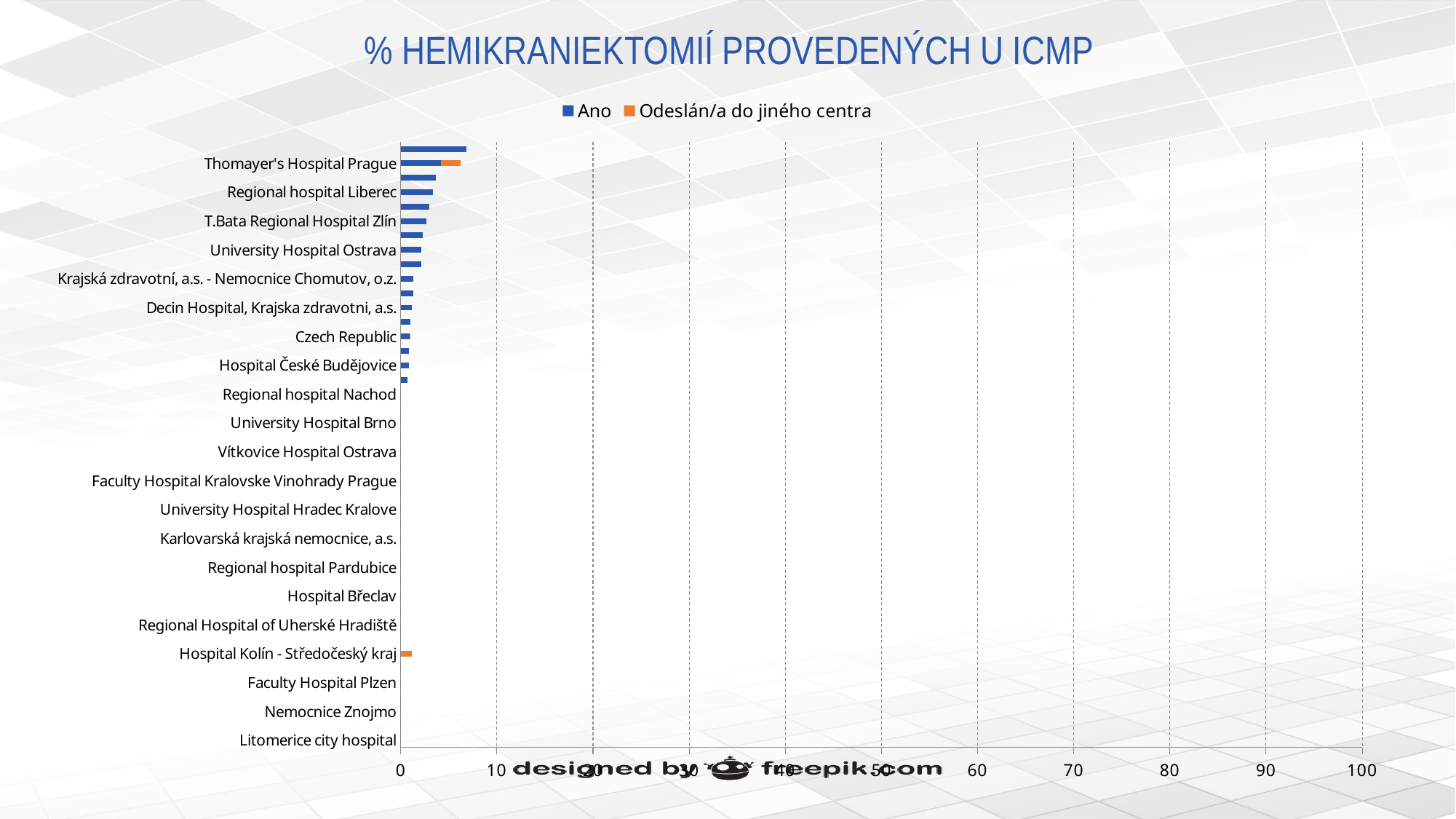
How many categories are labelled on the vertical axis? 21 Which category is listed at the bottom of the vertical axis? Litomerice city hospital Which series has the longest bar in the chart, Ano or Odeslán/a do jiného centra? Ano What kind of chart is shown on the slide? bar chart What is the highest value shown on the horizontal axis? 100 Is the longest bar in the chart greater or less than 50? less How many series does the legend list? 2 What are the two series named in the legend? Ano; Odeslán/a do jiného centra Is the longest bar in the chart greater or less than 10? less